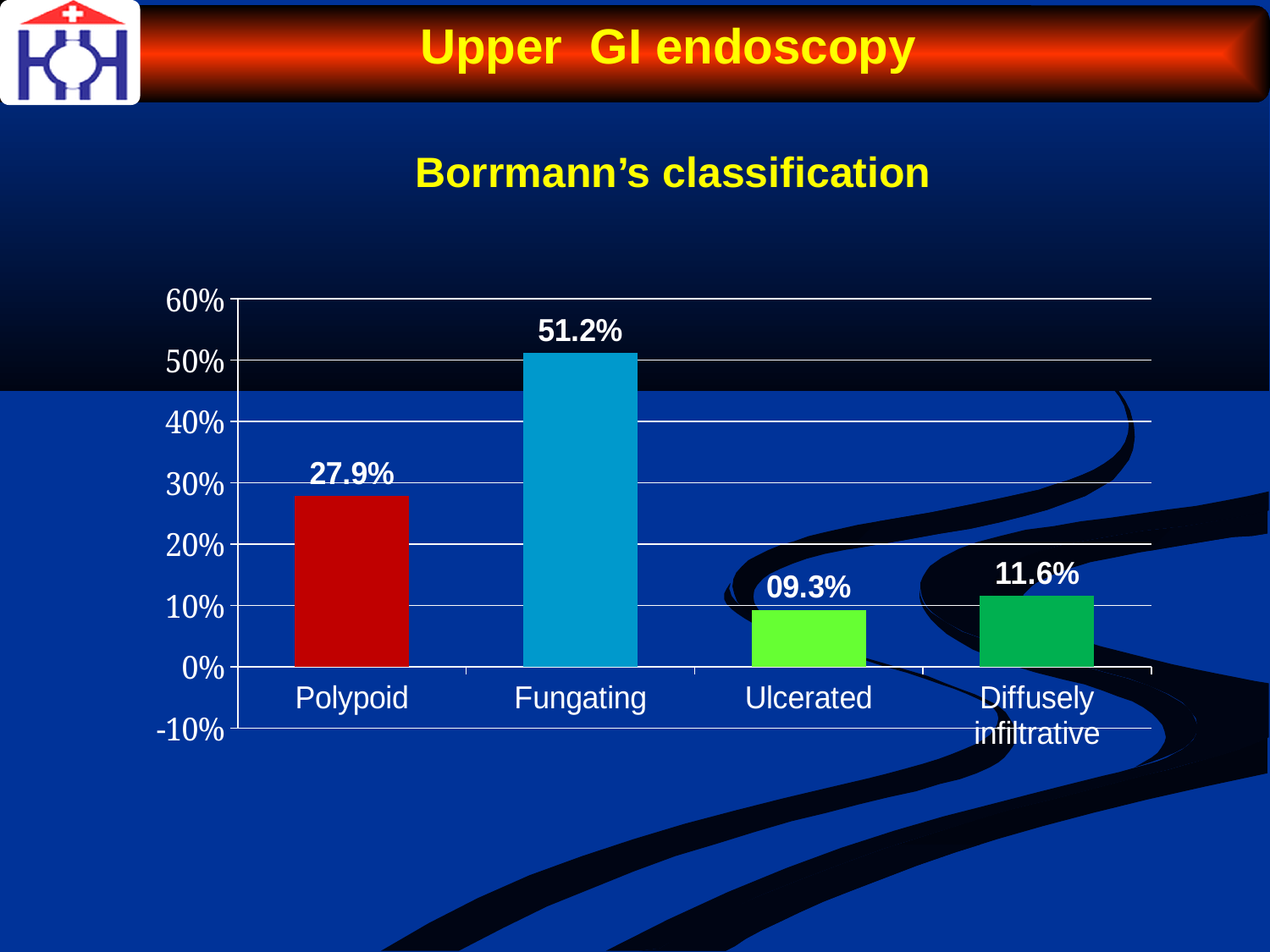
What is the difference between the values for Fungating and Polypoid? 23.3% What is the title of the chart? Borrmann's classification What kind of chart is shown on the slide? bar chart Which category has the highest value? Fungating How many categories are shown on the x axis? 4 What is the value for Polypoid? 27.9% What is the value for Diffusely infiltrative? 11.6% What is the value for Ulcerated? 09.3% What is the value for Fungating? 51.2% Which is larger, the value for Polypoid or the value for Diffusely infiltrative? Polypoid Is the value for Fungating greater or less than 50%? greater Which category has the lowest value? Ulcerated